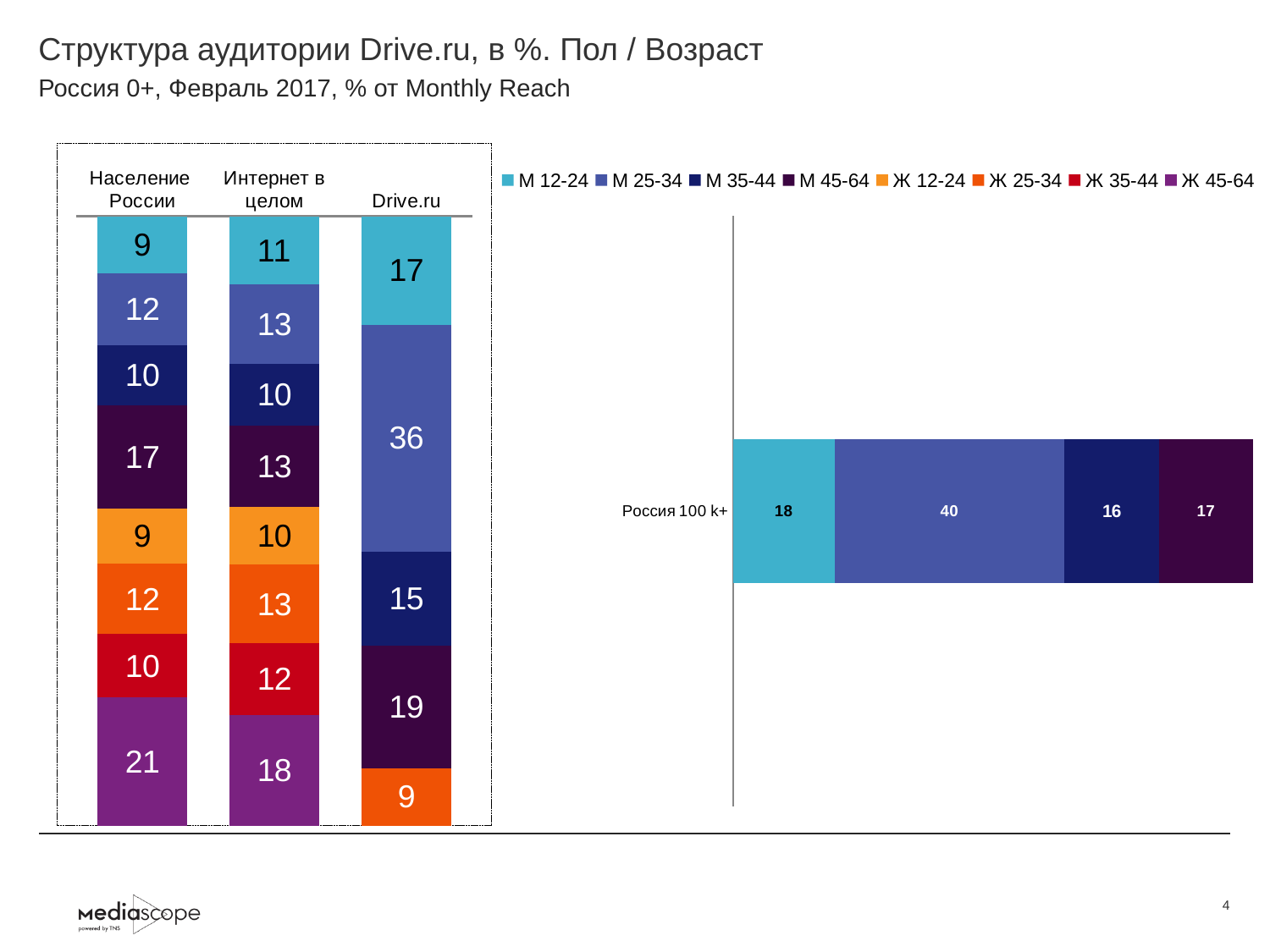
In the left chart, what is the value of the М 45-64 segment for Интернет в целом? 13 In the right chart, what is the total of the Россия 100 k+ bar? 91 In the left chart, which is larger: the Ж 45-64 value for Население России or for Интернет в целом? Население России How many bars (categories) does the left chart show? 3 In the right chart (Россия 100 k+), what is the value of the М 25-34 segment? 40 How many series does the legend list? 8 In the left chart, which segment of the Drive.ru bar is the largest? М 25-34 In the left chart, what is the value of the Ж 45-64 segment for Население России? 21 What type of chart is the right chart (Россия 100 k+)? Stacked bar chart In the left chart, what is the value of the М 25-34 segment for Drive.ru? 36 In the left chart, what is the difference between the М 25-34 values for Drive.ru and Население России? 24 In the left chart, which segment of the Drive.ru bar is the smallest? Ж 25-34